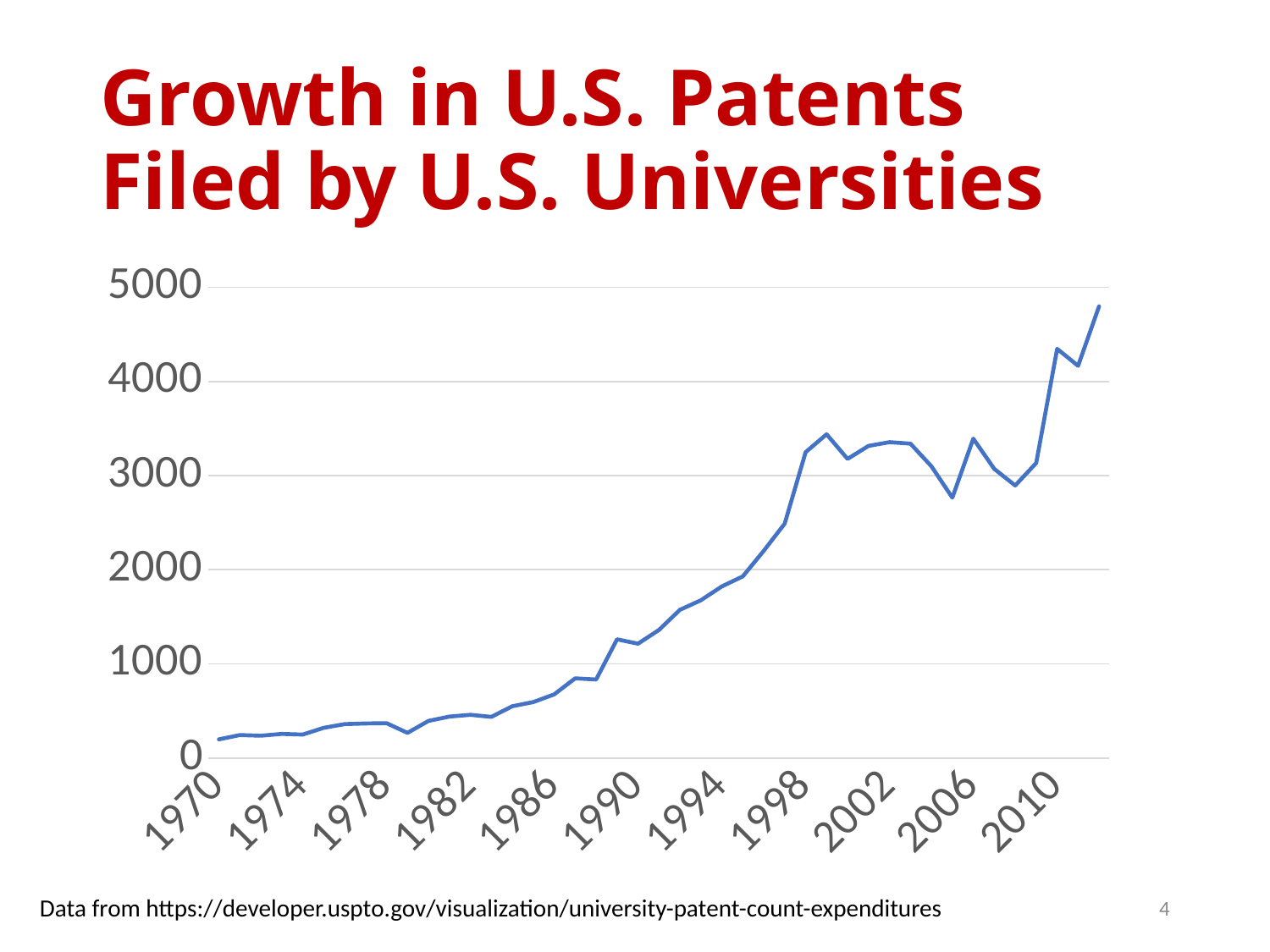
What kind of chart is shown on the slide? line chart What is the highest value shown on the vertical axis? 5000 Is the value for 1970 greater or less than 1000? less Is the value for 1994 greater or less than 2000? less Is the value for 2002 greater or less than 3000? greater Which year has a higher value, 1990 or 2002? 2002 Which year has a higher value, 1978 or 1998? 1998 What is the title of the chart? Growth in U.S. Patents Filed by U.S. Universities Overall, do the values rise or fall from 1970 to the end of the series? rise